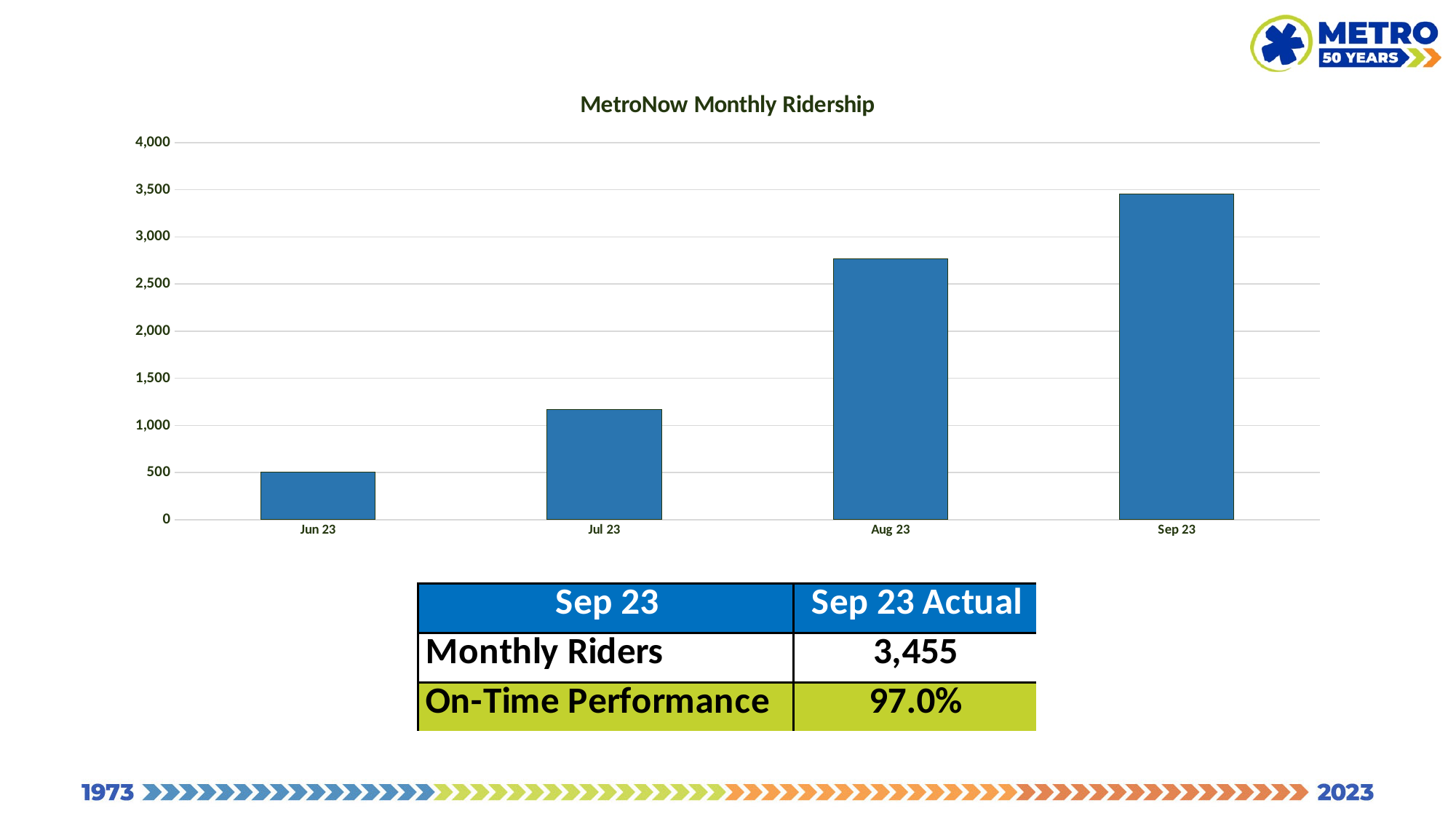
Which month has the lowest ridership in the chart? Jun 23 Is the ridership for Jul 23 greater or less than 1,000? greater Is the ridership for Aug 23 greater or less than 3,000? less Is the ridership for Jun 23 greater or less than 1,000? less What kind of chart is shown on the slide? bar chart Which month has the highest ridership in the chart? Sep 23 What is the title of the chart? MetroNow Monthly Ridership What is the monthly ridership for Sep 23? 3,455 What is the On-Time Performance shown for Sep 23 in the table below the chart? 97.0% How many months are plotted in the MetroNow Monthly Ridership chart? 4 Which month has higher ridership, Jul 23 or Aug 23? Aug 23 Do ridership values rise or fall from Jun 23 to Sep 23? rise